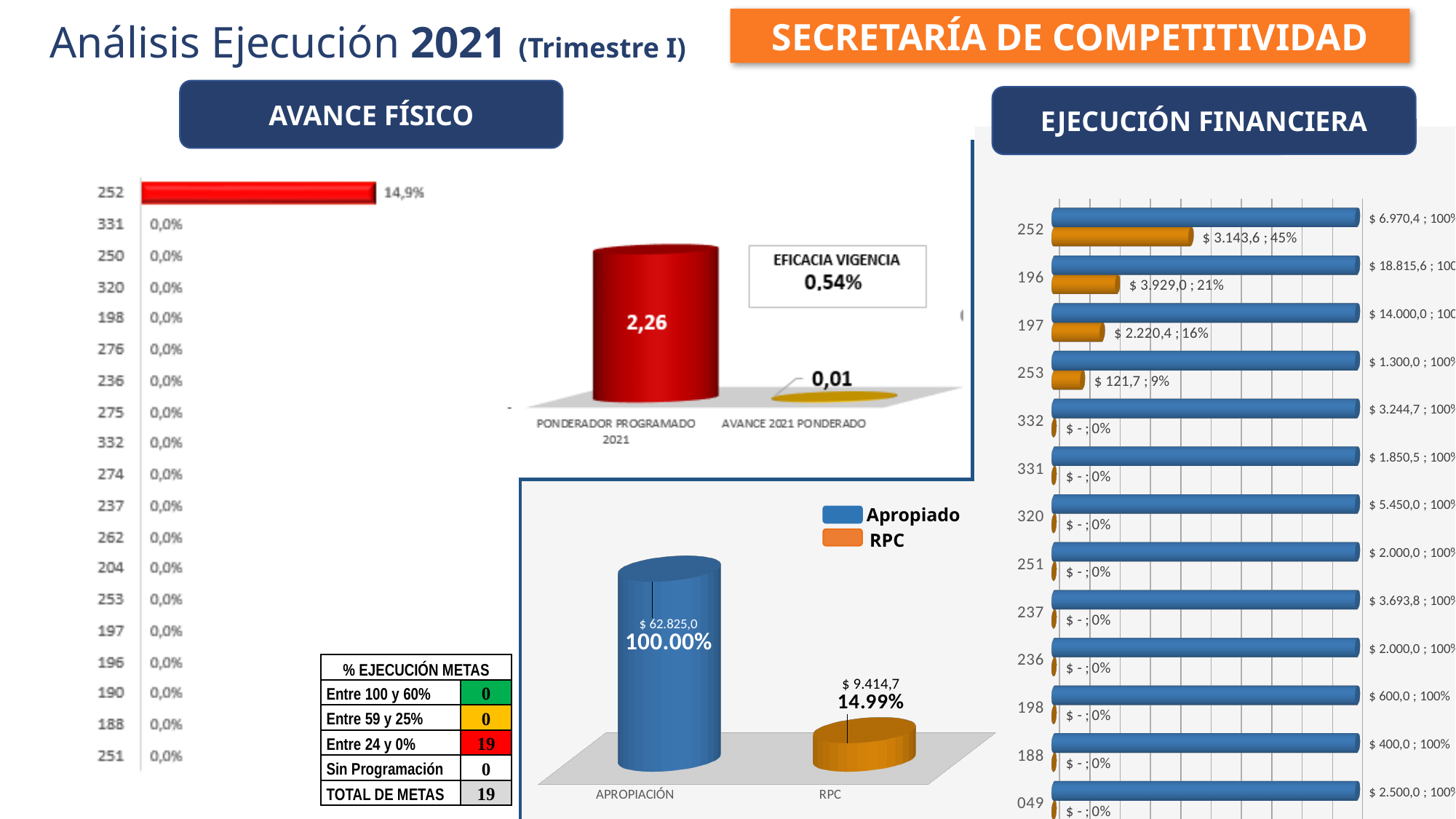
In the chart with APROPIACIÓN and RPC at the bottom centre, what amount is shown for APROPIACIÓN? $ 62.825,0 In the chart with PONDERADOR PROGRAMADO 2021 and AVANCE 2021 PONDERADO, what is the value for AVANCE 2021 PONDERADO? 0,01 What kind of chart is the Avance Físico chart on the left? bar chart In the Avance Físico bar chart on the left, how many categories are plotted? 19 How many series does the legend of the APROPIACIÓN / RPC chart list? 2 In the Ejecución Financiera bar chart on the right, how many categories are plotted? 13 In the Avance Físico bar chart on the left, which category has the highest value? 252 In the chart with APROPIACIÓN and RPC at the bottom centre, what percentage is shown for RPC? 14.99% In the Ejecución Financiera bar chart on the right, which category has the largest Apropiado amount? 196 In the chart with PONDERADOR PROGRAMADO 2021 and AVANCE 2021 PONDERADO, what is the value for PONDERADOR PROGRAMADO 2021? 2,26 In the Avance Físico bar chart on the left, what is the value for category 252? 14,9% In the Ejecución Financiera bar chart on the right, what is the RPC amount and percentage for category 196? $ 3.929,0 ; 21%